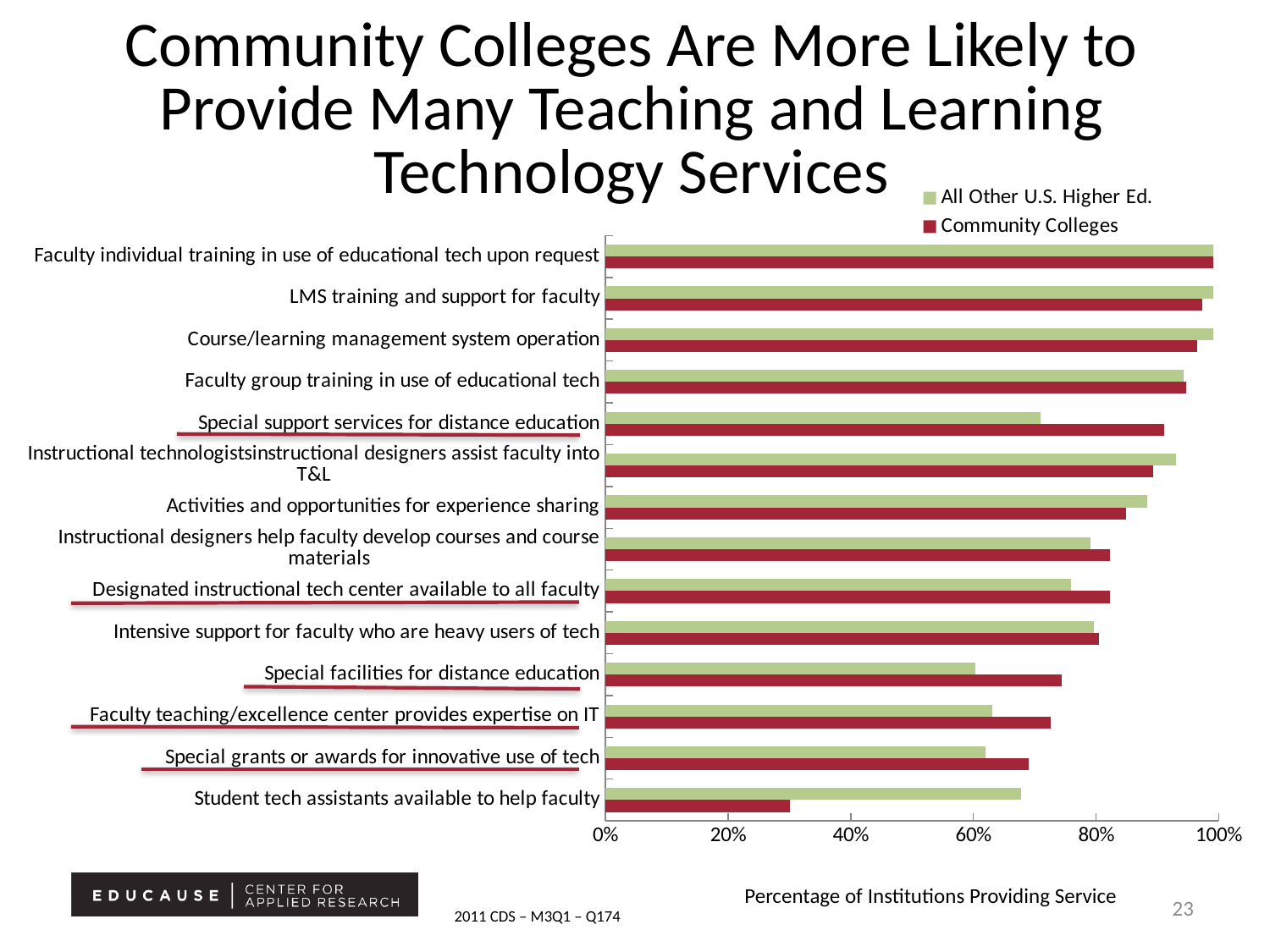
Is the Community Colleges value for 'Special support services for distance education' greater or less than 80%? greater For 'Student tech assistants available to help faculty', which series has the larger value? All Other U.S. Higher Ed. For 'Special facilities for distance education', which series has the larger value? Community Colleges How many series does the legend list? 2 How many service categories are plotted on the chart? 14 Is the Community Colleges value for 'Student tech assistants available to help faculty' greater or less than 40%? less What kind of chart is shown on the slide? bar chart Is the All Other U.S. Higher Ed. value for 'Special support services for distance education' greater or less than 80%? less What is the title of the horizontal axis? Percentage of Institutions Providing Service What colour represents the Community Colleges series? red For 'Special grants or awards for innovative use of tech', which series has the larger value? Community Colleges Which category has the lowest Community Colleges value? Student tech assistants available to help faculty